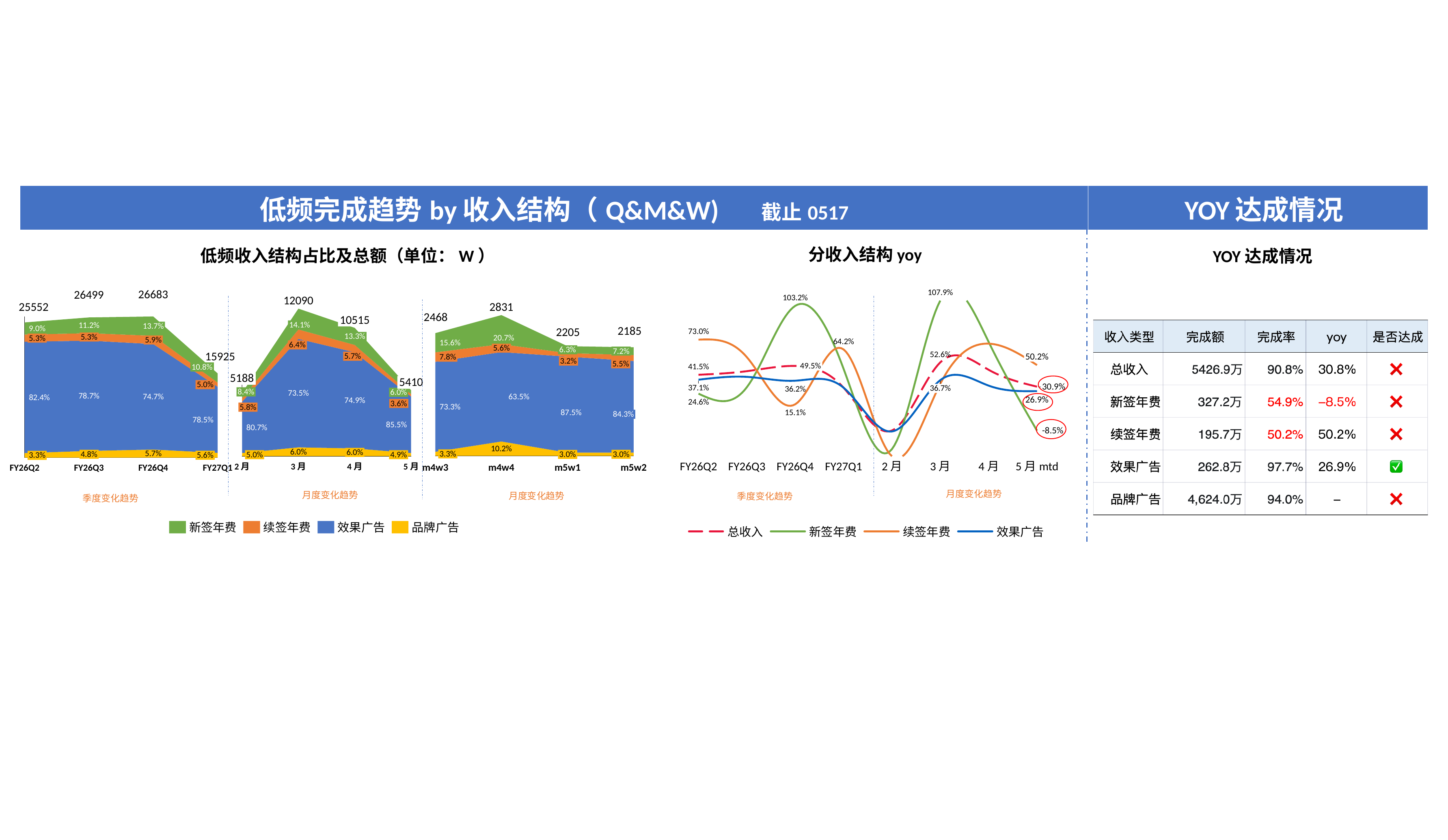
In the left chart 低频收入结构占比及总额, what is the total for FY26Q4? 26683 In the left chart 低频收入结构占比及总额, which quarter has the highest total? FY26Q4 In the right chart 分收入结构 yoy, what is the yoy value of 续签年费 for 5月 mtd? 50.2% What kind of chart is the right chart 分收入结构 yoy? line chart In the left chart 低频收入结构占比及总额, which month has the larger total, 3月 or 4月? 3月 In the left chart 低频收入结构占比及总额, how many weekly points (m4w3 to m5w2) are shown? 4 In the right chart 分收入结构 yoy, what is the yoy value of 新签年费 for 3月? 107.9% In the right chart 分收入结构 yoy, which series is drawn as a red dashed line? 总收入 How many series does the legend of the left chart 低频收入结构占比及总额 list? 4 In the left chart 低频收入结构占比及总额, what is the difference between the FY26Q4 total and the FY26Q2 total? 1131 In the left chart 低频收入结构占比及总额, what is the share of 效果广告 in m5w1? 87.5% In the right chart 分收入结构 yoy, at which period is 新签年费 lowest? 2月